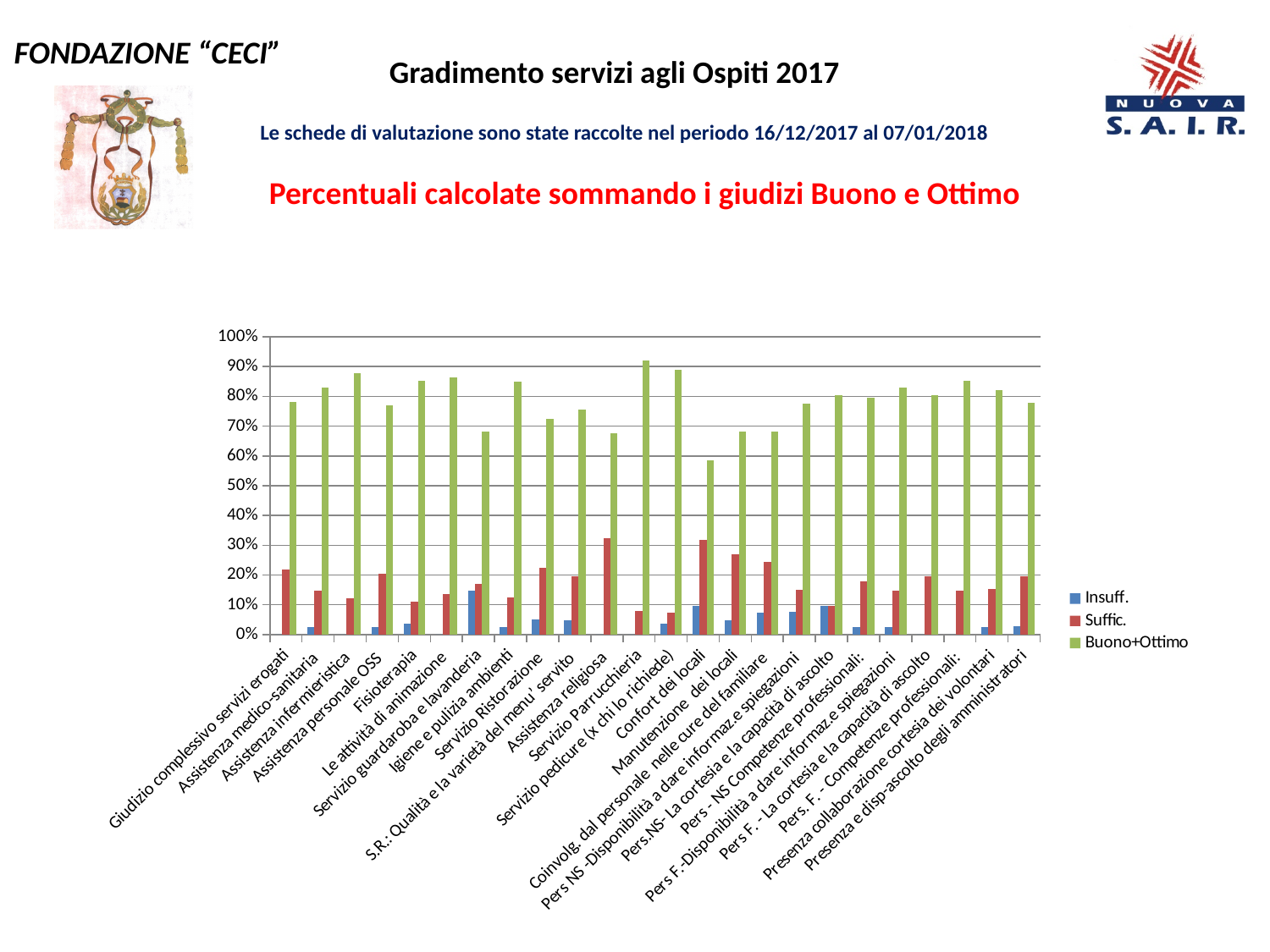
How many series does the legend list? 3 Which colour represents the Buono+Ottimo series? green Which category has the highest Insuff. value? Servizio guardaroba e lavanderia Which has the larger Buono+Ottimo value, Assistenza infermieristica or Assistenza personale OSS? Assistenza infermieristica Which category has the highest Buono+Ottimo value? Servizio Parrucchieria How many service categories are plotted along the x axis? 24 What are the three series named in the legend? Insuff., Suffic., Buono+Ottimo Which category has the lowest Buono+Ottimo value? Confort dei locali Is the Buono+Ottimo value for Servizio Parrucchieria greater or less than 90%? greater Is the Suffic. value for Assistenza religiosa greater or less than 30%? greater Is the Buono+Ottimo value for Confort dei locali greater or less than 60%? less What kind of chart is shown on the slide? bar chart